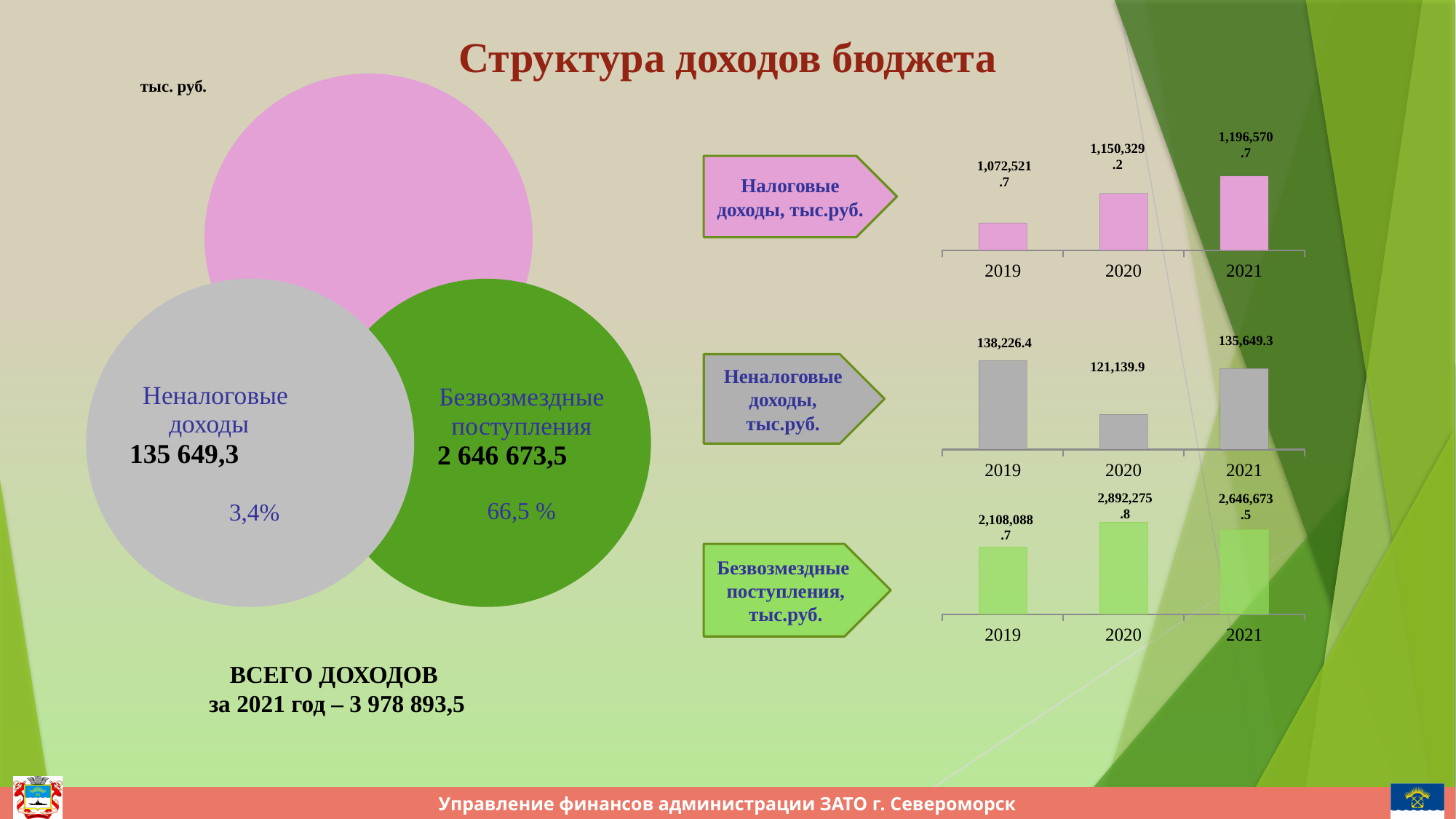
In the Налоговые доходы chart, what is the value for 2021? 1,196,570.7 In the Безвозмездные поступления chart, what is the difference between the 2020 and 2021 values? 245,602.3 In the Неналоговые доходы chart, what is the value for 2019? 138,226.4 In the Налоговые доходы chart, do the values rise or fall from 2019 to 2021? rise What type of chart is the Налоговые доходы chart? bar chart In the Безвозмездные поступления chart, what is the value for 2020? 2,892,275.8 In the Неналоговые доходы chart, which year has the lowest value? 2020 How many years (bars) are shown in the Безвозмездные поступления chart? 3 In the Неналоговые доходы chart, which is larger, the value for 2019 or for 2021? 2019 In the Налоговые доходы chart, what is the difference between the 2020 and 2019 values? 77,807.5 In the Безвозмездные поступления chart, which year has the highest value? 2020 In the Неналоговые доходы chart, what is the difference between the 2019 and 2020 values? 17,086.5